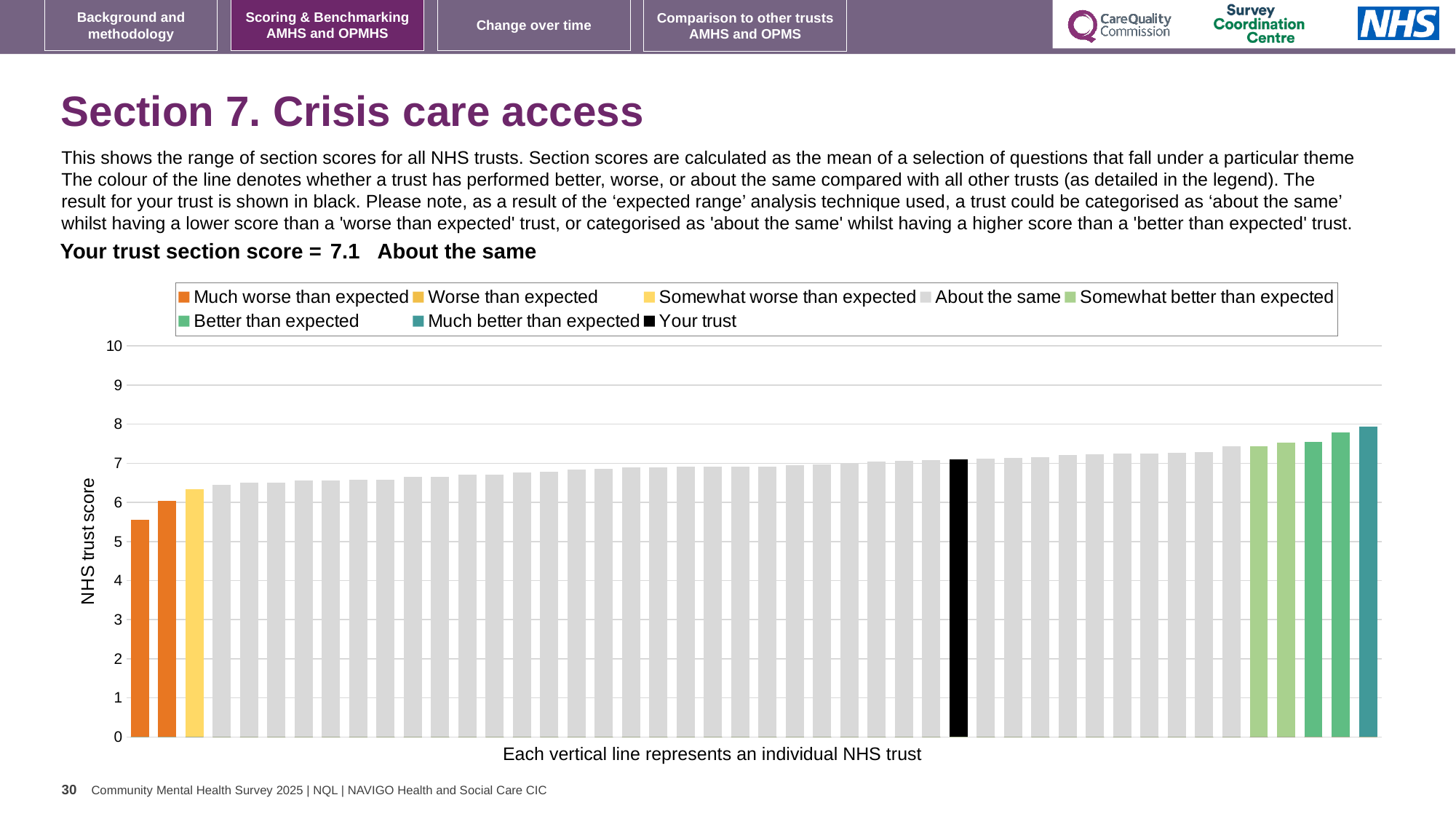
What is the section score for your trust shown on the slide? 7.1 What kind of chart is shown on the slide? Bar chart Which category is your trust placed in for this section? About the same Is the value of the shortest bar greater or less than 6? less Which legend category does the tallest bar belong to? Much better than expected What is the label on the vertical axis of the chart? NHS trust score How many bars are coloured as 'Much worse than expected'? 2 Which legend category does the shortest bar belong to? Much worse than expected Which is larger, the black 'Your trust' bar or the leftmost orange bar? The black 'Your trust' bar Do the bar values rise or fall from left to right along the x axis? Rise Is the value of the tallest bar greater or less than 7? greater How many entries does the chart legend list? 8